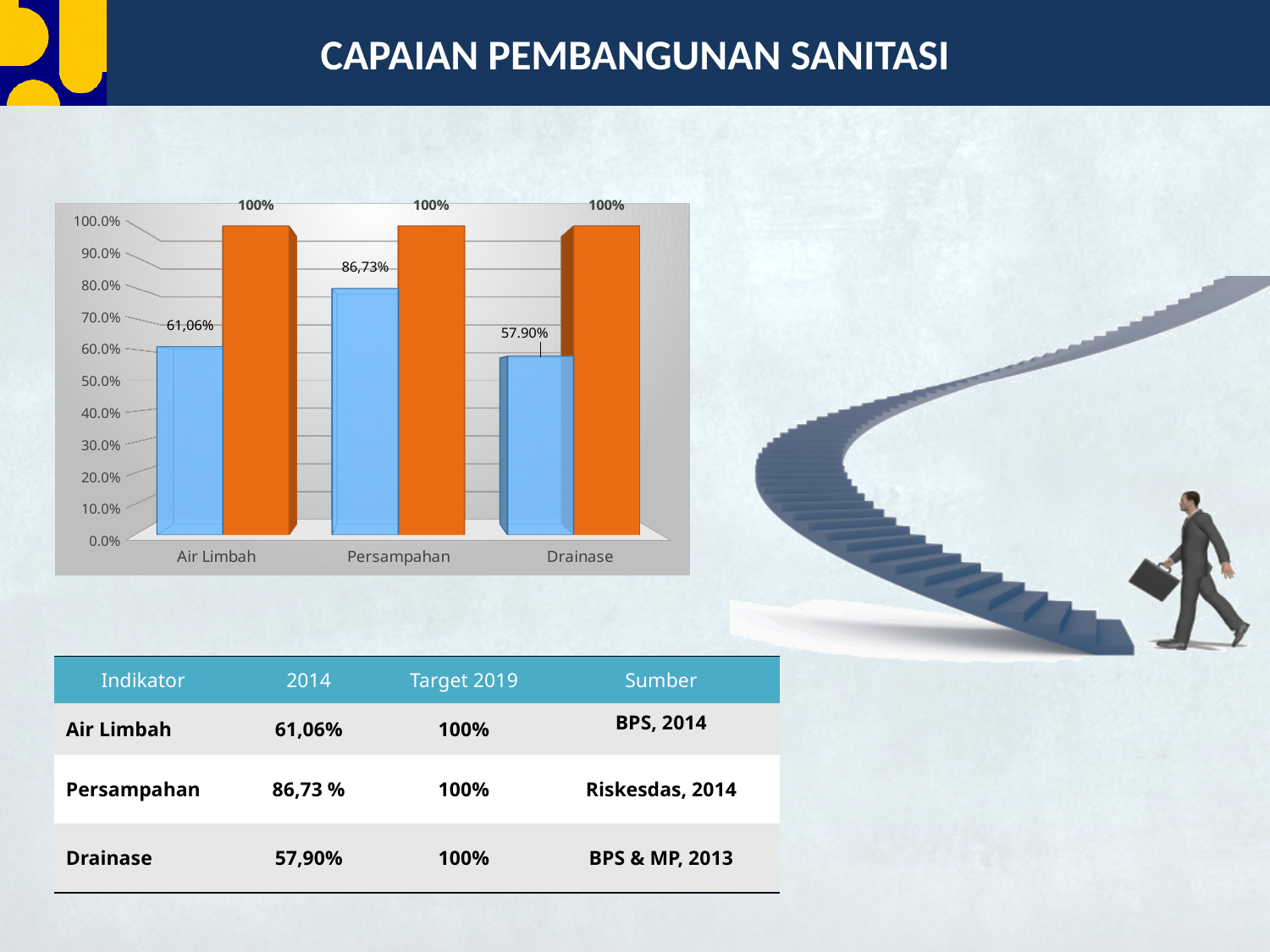
What value is labelled on the blue bar for Persampahan? 86,73% What is the difference between the orange bar and the blue bar for Air Limbah? 38,94% What value is labelled on the blue bar for Drainase? 57.90% How many categories are shown on the x axis of the chart? 3 Which category has the highest blue bar? Persampahan Which category has the lowest blue bar? Drainase What value is labelled on the blue bar for Air Limbah? 61,06% Which is larger, the blue bar for Air Limbah or the blue bar for Drainase? Air Limbah What is the difference between the blue bar values for Persampahan and Air Limbah? 25,67% What value is labelled on the orange bar for Drainase? 100% What kind of chart is shown on the slide? bar chart